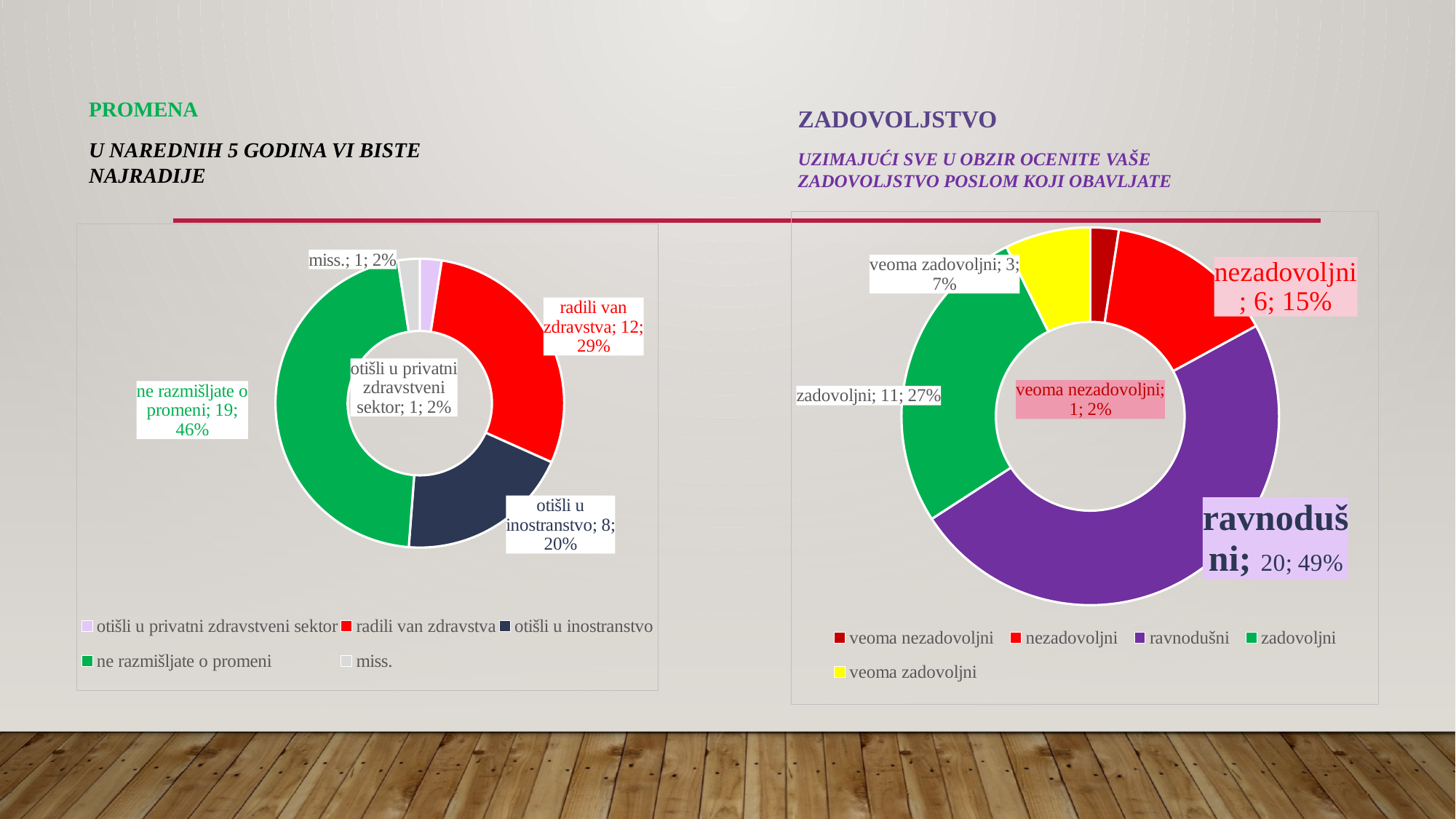
In the PROMENA chart on the left, how many categories does the legend list? 5 In the ZADOVOLJSTVO chart on the right, what percentage share does 'zadovoljni' have? 27% In the ZADOVOLJSTVO chart on the right, which is larger: 'nezadovoljni' or 'veoma zadovoljni'? nezadovoljni In the ZADOVOLJSTVO chart on the right, how many respondents are 'ravnodušni'? 20 In the ZADOVOLJSTVO chart on the right, what colour represents 'veoma zadovoljni'? Yellow In the ZADOVOLJSTVO chart on the right, what is the difference in count between 'ravnodušni' and 'zadovoljni'? 9 In the PROMENA chart on the left, what is the difference in count between 'radili van zdravstva' and 'otišli u inostranstvo'? 4 What type of chart is used on the right side of the slide? Pie (doughnut) chart In the ZADOVOLJSTVO chart on the right, which category has the smallest share? veoma nezadovoljni In the PROMENA chart on the left, which category has the largest share? ne razmišljate o promeni In the PROMENA chart on the left, what percentage share does 'radili van zdravstva' have? 29% In the PROMENA chart on the left, how many respondents chose 'ne razmišljate o promeni'? 19